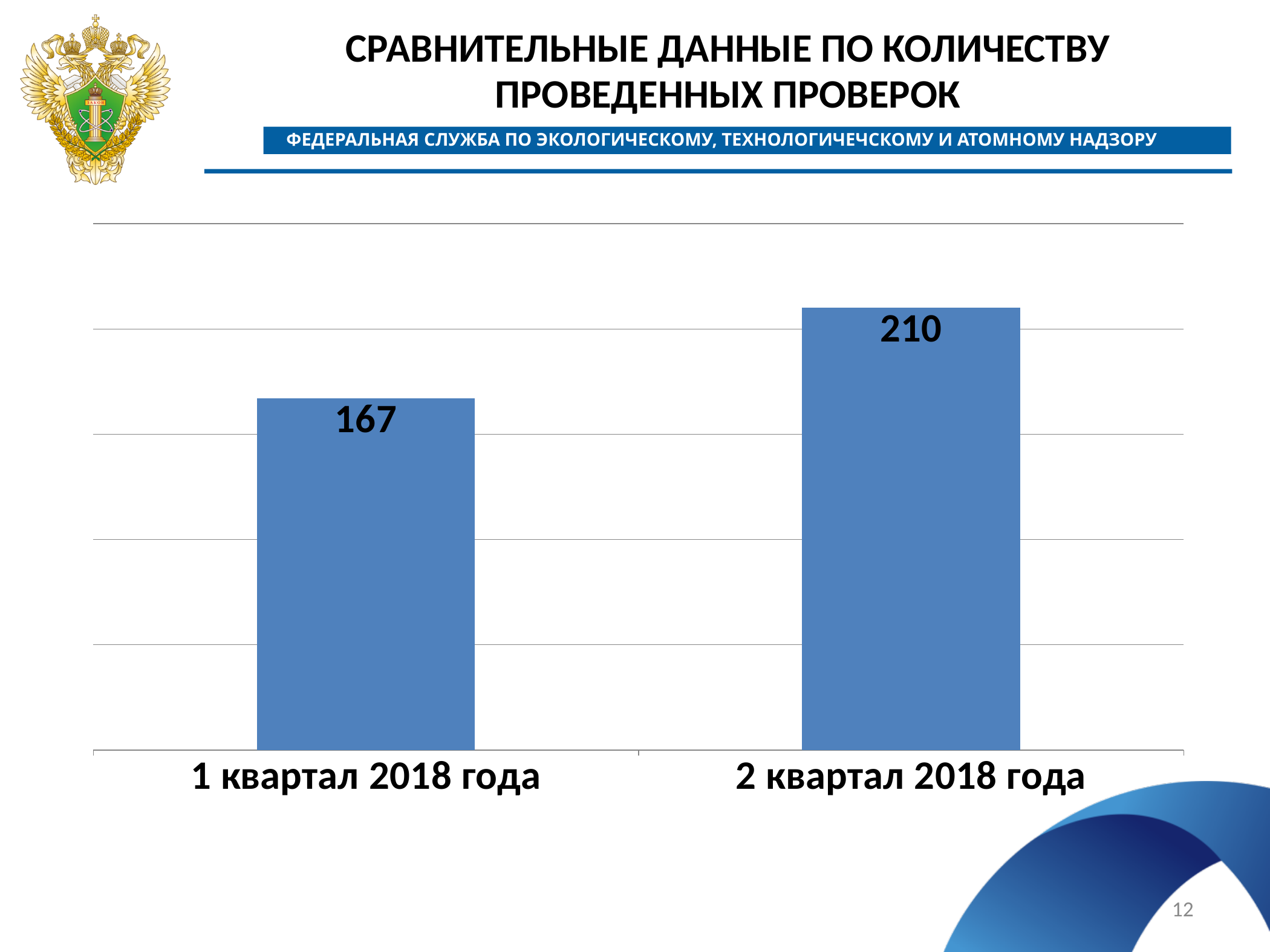
What colour are the bars in the chart? blue What is the value for 1 квартал 2018 года? 167 Do the values rise or fall from 1 квартал 2018 года to 2 квартал 2018 года? rise What is the total of the two bars shown? 377 What is the difference between the values for 2 квартал 2018 года and 1 квартал 2018 года? 43 What is the value for 2 квартал 2018 года? 210 Which category has the highest value? 2 квартал 2018 года What is the title of the slide containing the chart? СРАВНИТЕЛЬНЫЕ ДАННЫЕ ПО КОЛИЧЕСТВУ ПРОВЕДЕННЫХ ПРОВЕРОК How many categories are shown on the x axis? 2 What kind of chart is shown on the slide? bar chart Which is larger, the value for 1 квартал 2018 года or 2 квартал 2018 года? 2 квартал 2018 года Which category has the lowest value? 1 квартал 2018 года